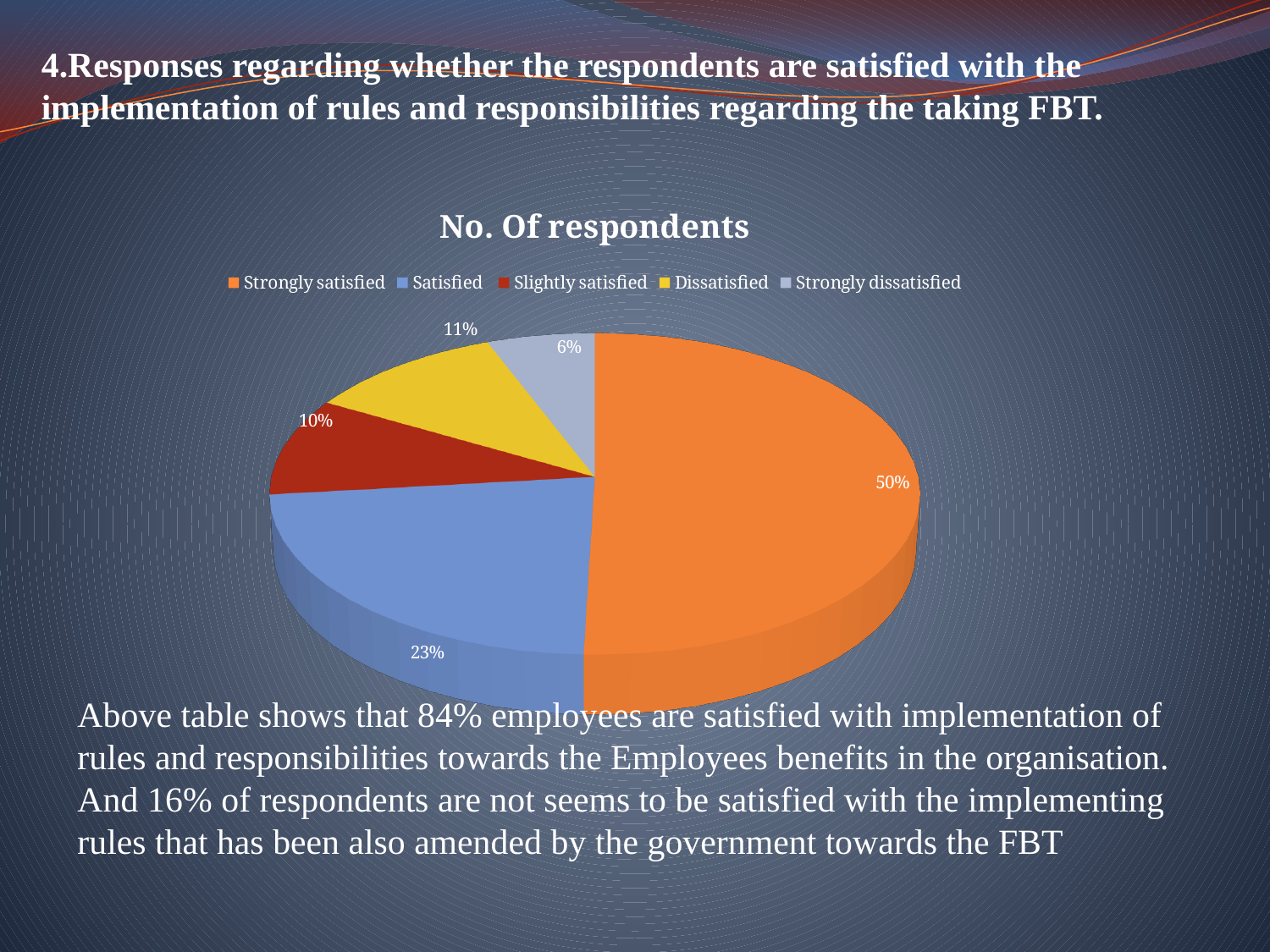
Which is larger, the share for Dissatisfied or the share for Strongly dissatisfied? Dissatisfied What percentage of respondents are Slightly satisfied? 10% What is the title of the chart? No. Of respondents What percentage of respondents are Strongly satisfied? 50% What kind of chart is shown on the slide? pie chart How many categories does the legend list? 5 What percentage of respondents are Dissatisfied? 11% Which category has the largest share of the pie? Strongly satisfied What percentage of respondents are Strongly dissatisfied? 6% What percentage of respondents are Satisfied? 23% Which category has the smallest share of the pie? Strongly dissatisfied What is the difference in percentage points between Strongly satisfied and Satisfied? 27